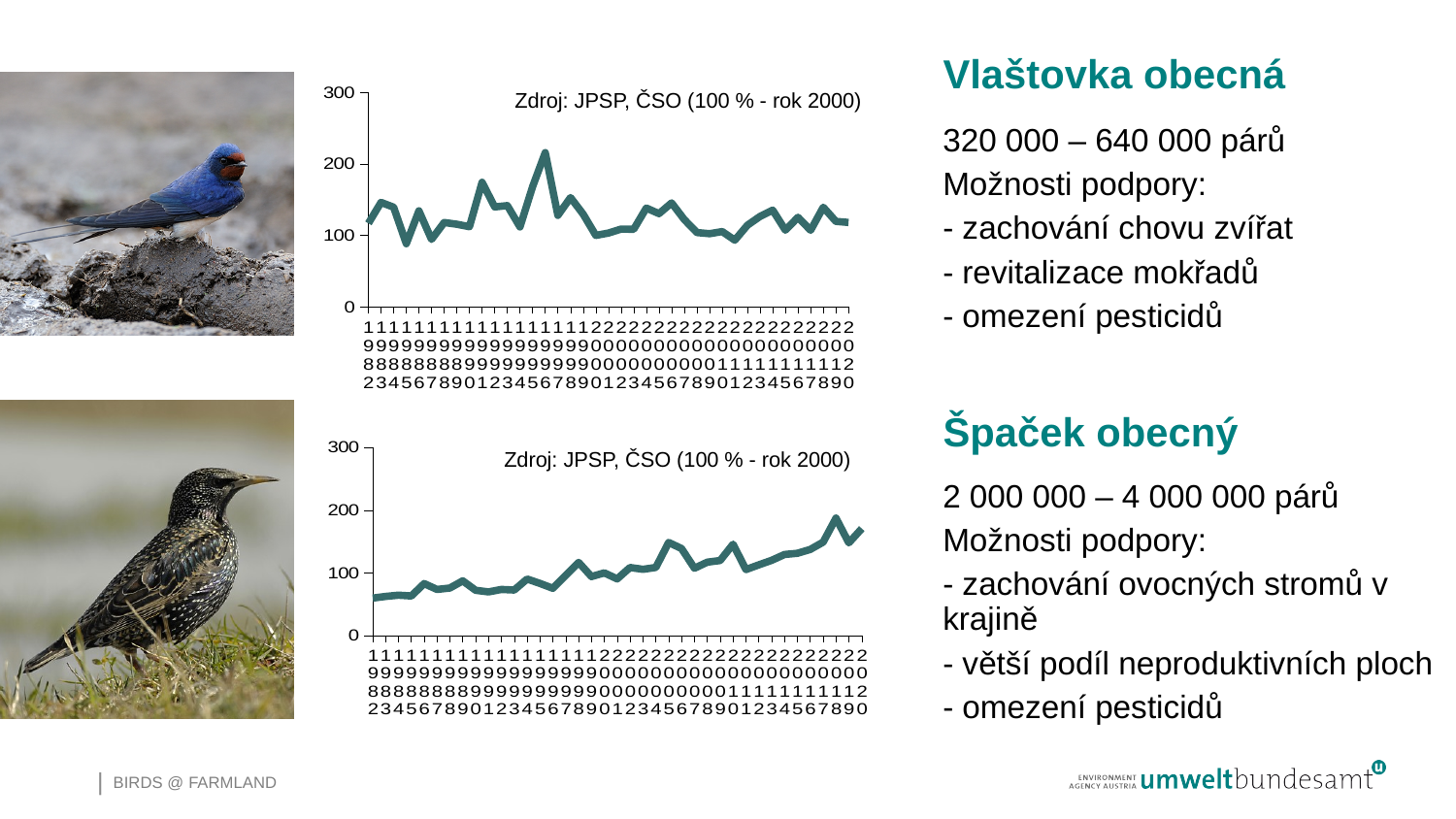
In the bottom chart, which year has the highest value? 2018 In the bottom chart, do the values generally rise or fall from 1982 to 2020? rise In the top chart, is the value for 2010 greater or less than 200? less What source text is printed on the top chart? Zdroj: JPSP, ČSO (100 % - rok 2000) In the top chart, which year has the highest value? 1996 In the bottom chart, is the value for 1982 greater or less than 100? less In the bottom chart, is the value for 2019 greater or less than 100? greater What kind of chart is the bottom chart on the slide? line chart How many charts are shown on the slide? 2 What is the highest value shown on the y axis of the bottom chart? 300 What kind of chart is the top chart on the slide? line chart